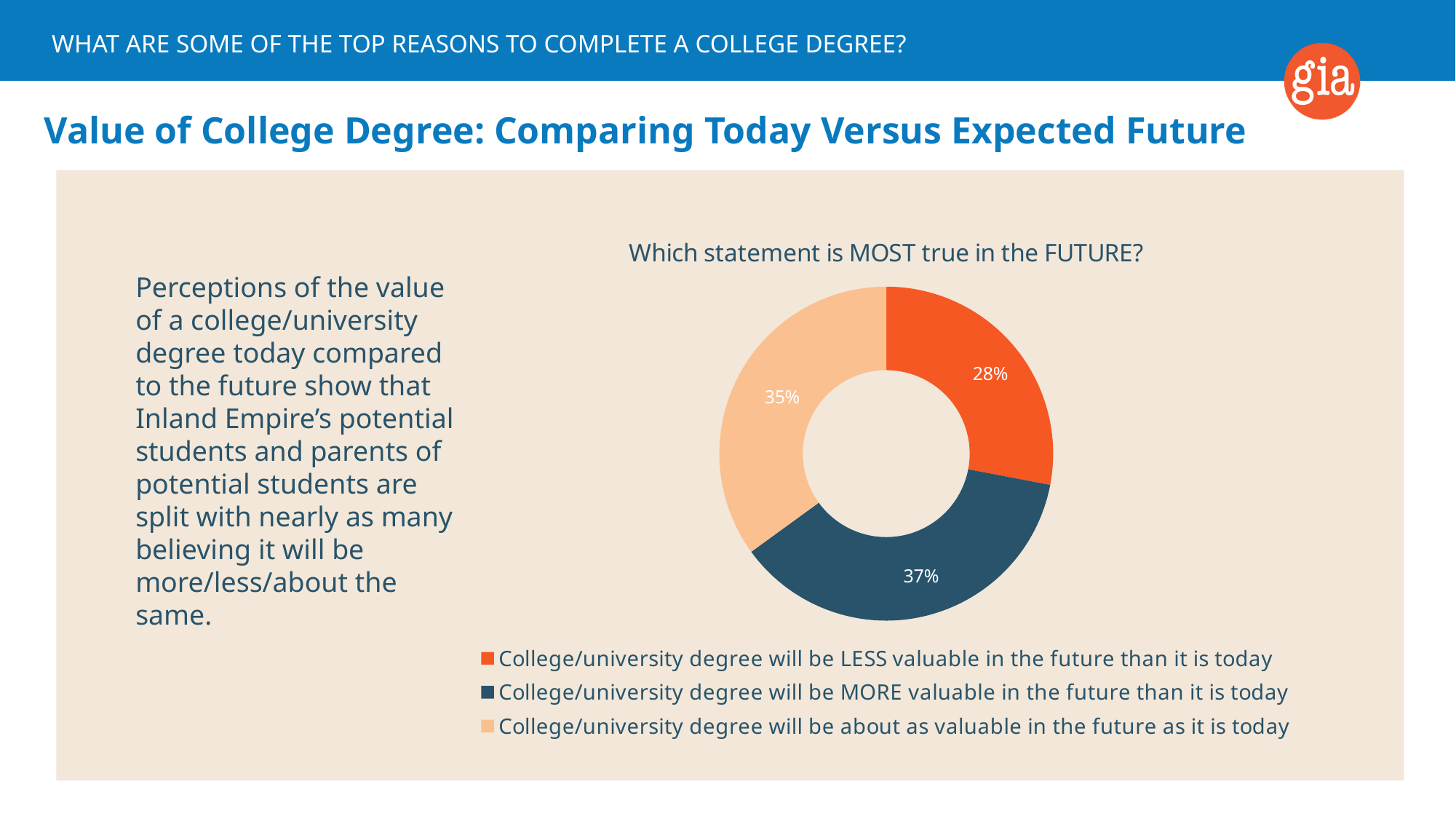
What colour represents the 'about as valuable' category in the chart? Light orange (peach) What is the title of the chart? Which statement is MOST true in the FUTURE? What is the difference in percentage points between the 'about as valuable' and 'LESS valuable' responses? 7 Which statement received the largest share of responses? College/university degree will be MORE valuable in the future than it is today What percentage of respondents said a college/university degree will be about as valuable in the future as it is today? 35% How many categories are shown in the chart? 3 What kind of chart is shown on the slide? Doughnut (pie) chart What is the difference in percentage points between the MORE valuable and LESS valuable responses? 9 Which is larger: the share saying the degree will be MORE valuable or the share saying it will be LESS valuable? MORE valuable What percentage of respondents said a college/university degree will be LESS valuable in the future than it is today? 28% Which statement received the smallest share of responses? College/university degree will be LESS valuable in the future than it is today What percentage of respondents said a college/university degree will be MORE valuable in the future than it is today? 37%